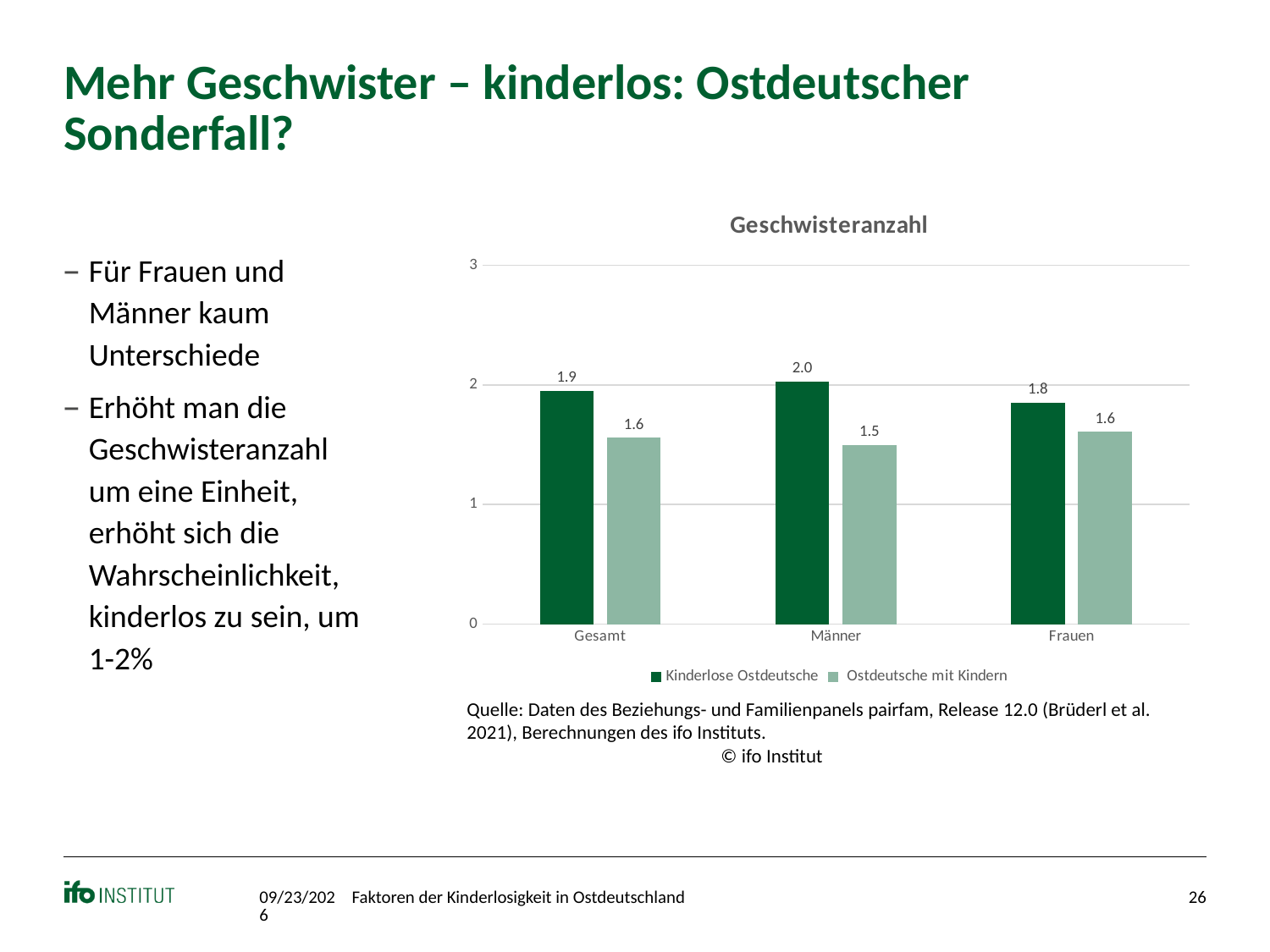
Which category has the highest value for Kinderlose Ostdeutsche? Männer What is the difference between Kinderlose Ostdeutsche and Ostdeutsche mit Kindern in the Männer category? 0.5 What is the title of the chart? Geschwisteranzahl Which category has the lowest value for Ostdeutsche mit Kindern? Männer Is the value for Ostdeutsche mit Kindern in the Gesamt category greater or less than 2? less In the Frauen category, which series has the larger value, Kinderlose Ostdeutsche or Ostdeutsche mit Kindern? Kinderlose Ostdeutsche What is the value for Kinderlose Ostdeutsche in the Frauen category? 1.8 What kind of chart is shown on the slide? bar chart What is the value for Kinderlose Ostdeutsche in the Gesamt category? 1.9 How many categories are shown on the x axis? 3 What is the value for Ostdeutsche mit Kindern in the Männer category? 1.5 How many series does the legend list? 2